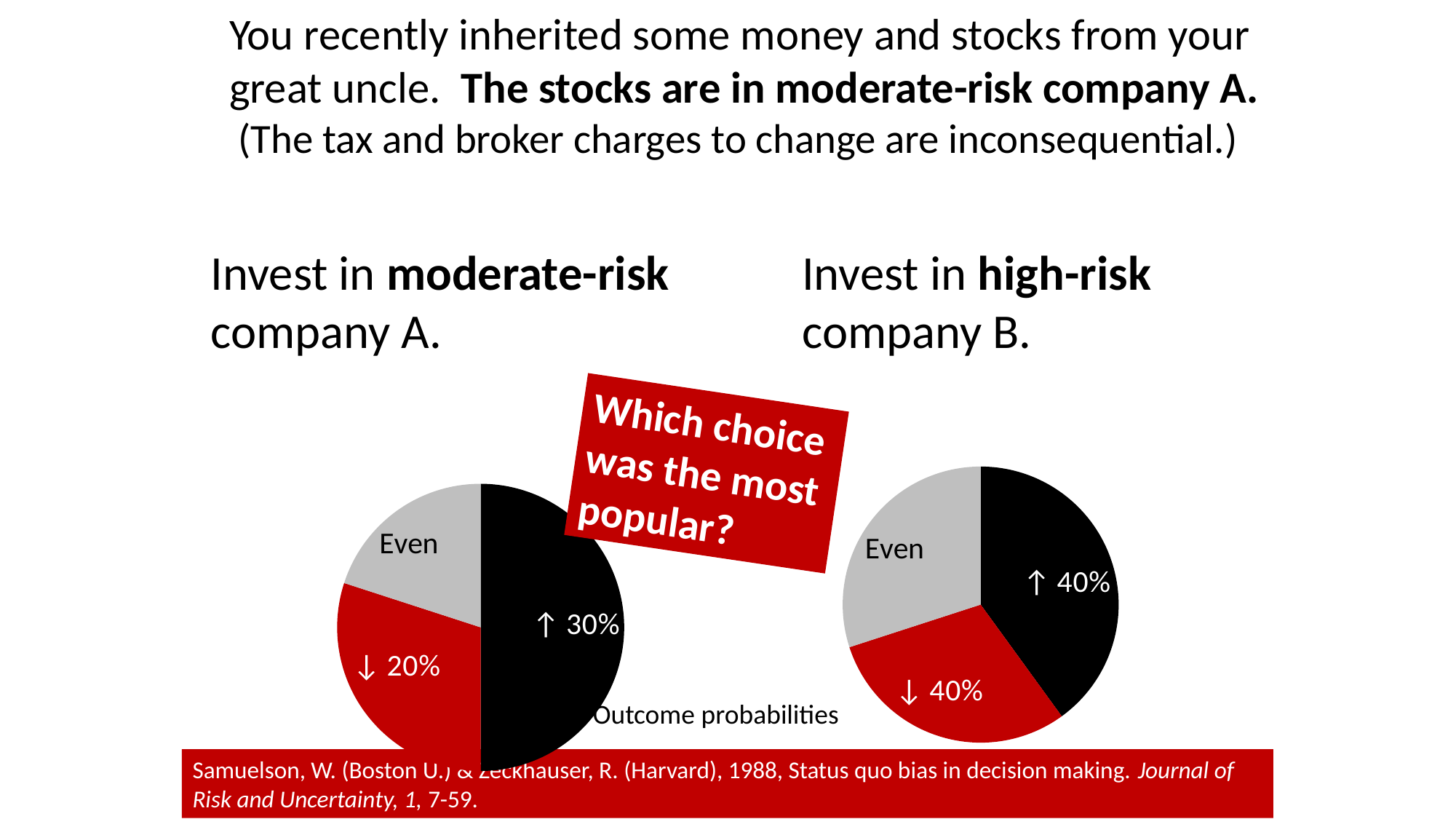
What caption appears between the two pie charts describing what they show? Outcome probabilities How many slices does the pie chart for moderate-risk company A (left) have? 3 What kind of chart is used to show the outcome probabilities for company A and company B? Pie chart In the pie chart for moderate-risk company A (left), which is larger: the up (↑) probability or the down (↓) probability? Up (↑) How many slices does the pie chart for high-risk company B (right) have? 3 Which company's pie chart shows the larger up (↑) probability, company A (left) or company B (right)? Company A In both pie charts, what colour is the 'Even' slice? Grey